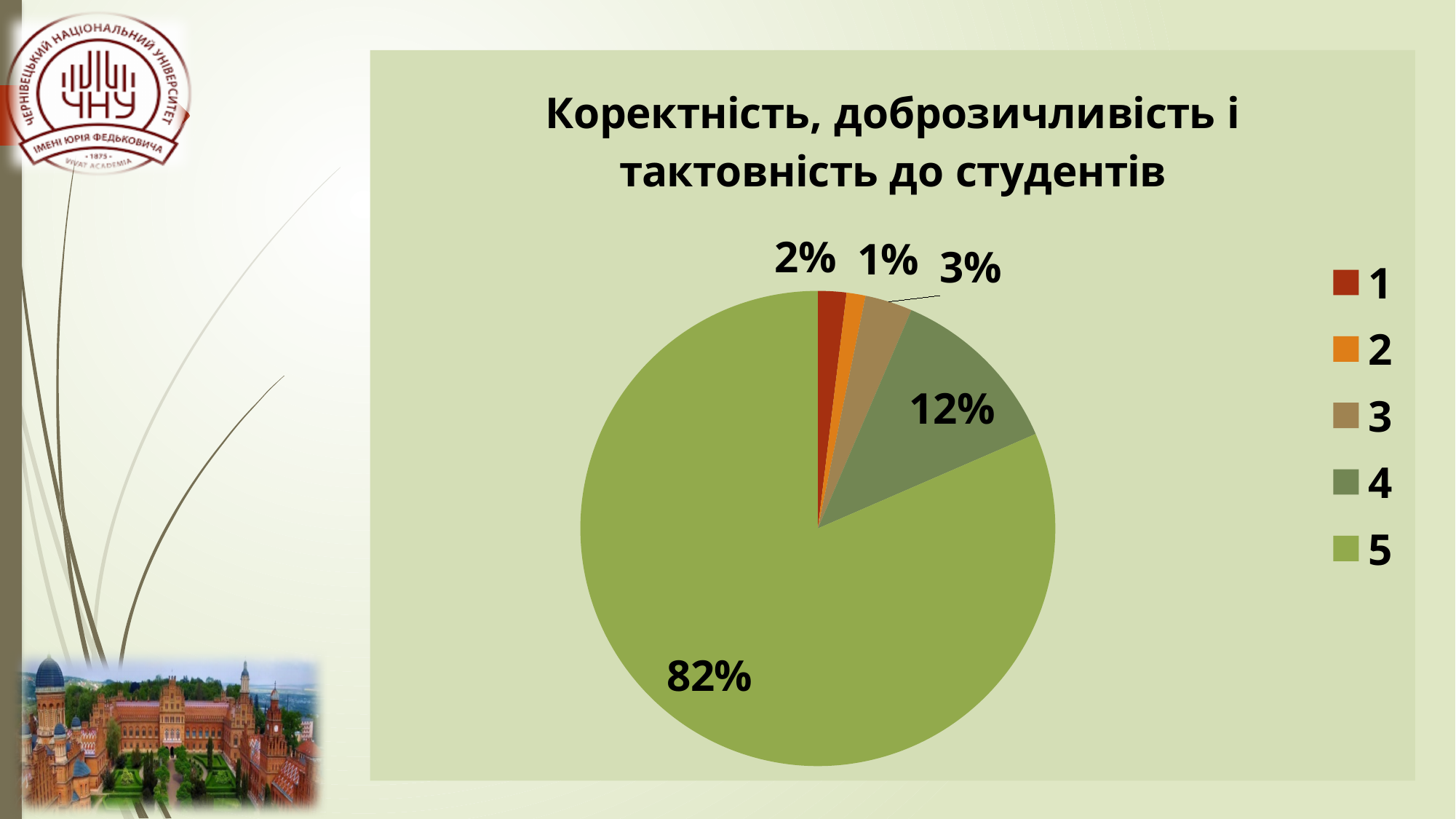
What is the difference between the values for category 5 and category 4? 70% What is the value for category 2? 1% What share of the pie does category 5 have? 82% What is the title of the chart? Коректність, доброзичливість і тактовність до студентів What is the value for category 1? 2% What is the value for category 3? 3% How many categories does the legend list? 5 What share of the pie does category 4 have? 12% Which category has the smallest slice? 2 Which category has the largest slice? 5 Which is larger, the value for category 3 or the value for category 1? category 3 What kind of chart is shown on the slide? pie chart